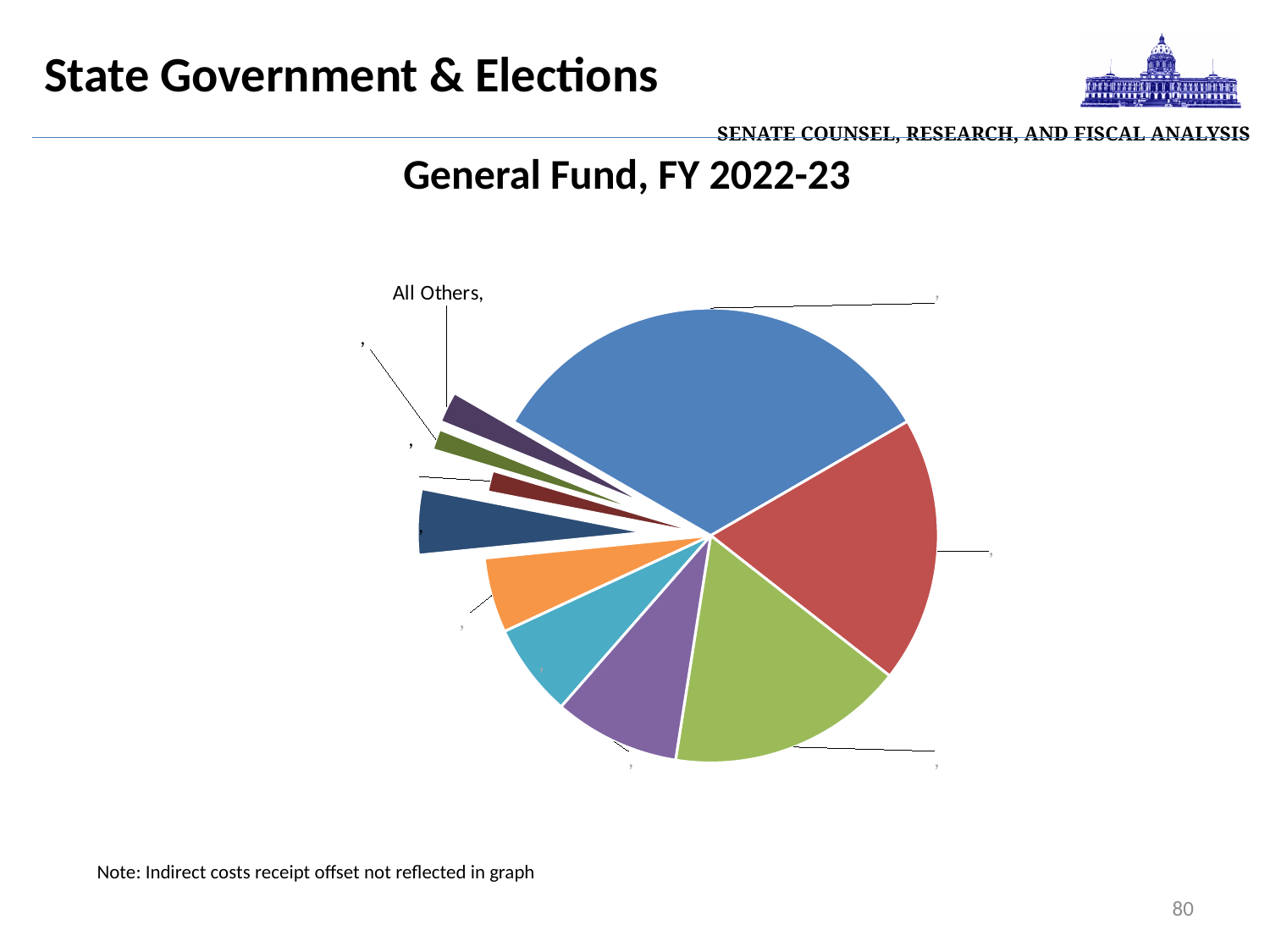
What is the title of the chart? General Fund, FY 2022-23 What kind of chart is shown on the slide? pie chart Which is larger, the blue slice or the red slice? the blue slice Which slice is labelled "All Others"? the dark purple exploded slice How many slices does the pie chart have? 10 Is the blue slice greater or less than half of the pie? less Which colour slice is the largest in the pie chart? blue Which is larger, the blue slice or the orange slice? the blue slice